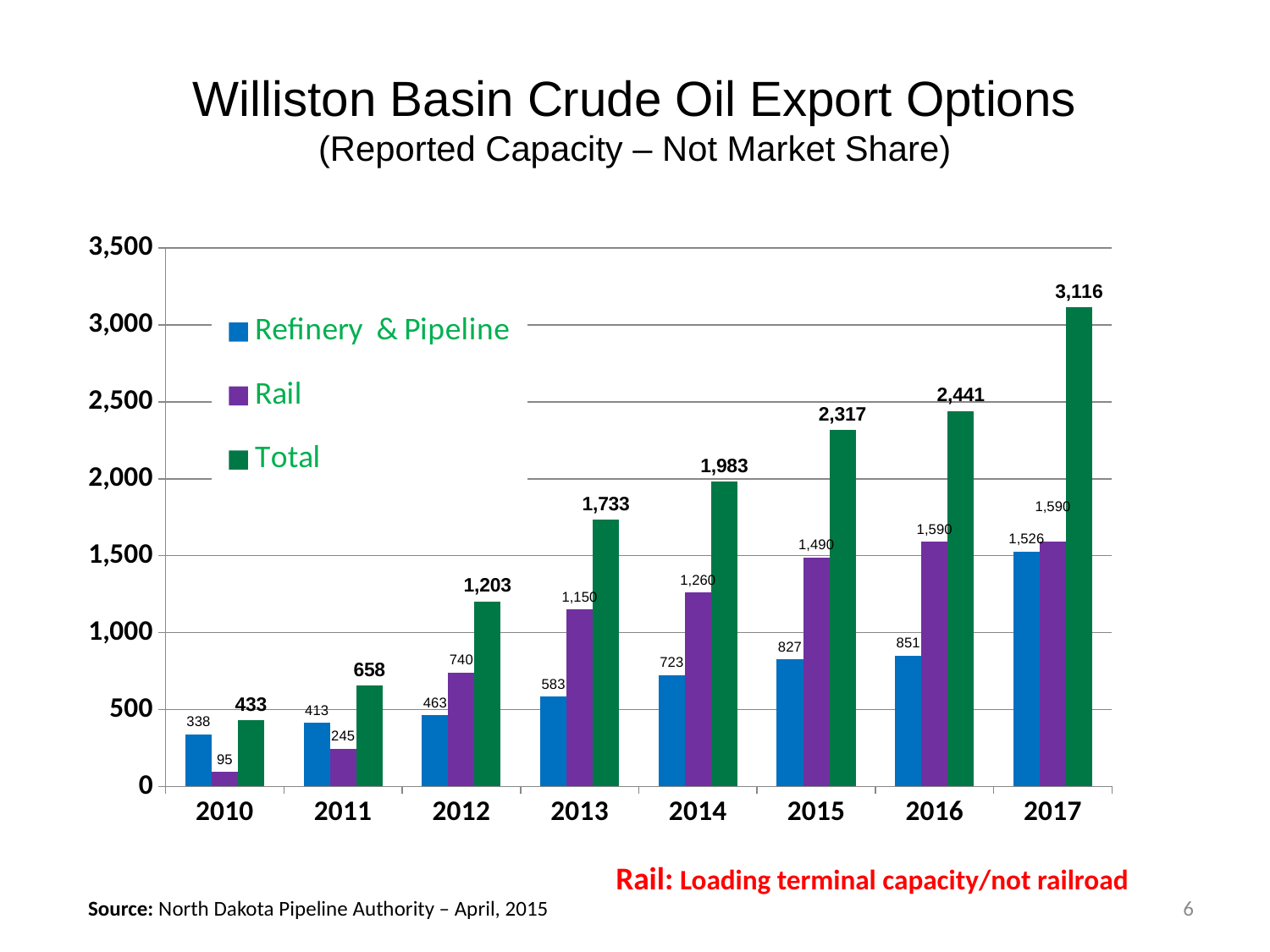
How many years are shown on the x axis? 8 How many series does the legend list? 3 What is the Rail value for 2014? 1,260 What is the Total value for 2017? 3,116 What is the difference between the Total values for 2017 and 2016? 675 Which is larger in 2013, the Rail value or the Refinery & Pipeline value? Rail What is the Rail value for 2010? 95 Which year has the lowest Rail value? 2010 What is the Refinery & Pipeline value for 2015? 827 What kind of chart is shown on the slide? Bar chart Does the Total value rise or fall from 2010 to 2017? Rise Which year has the highest Total value? 2017